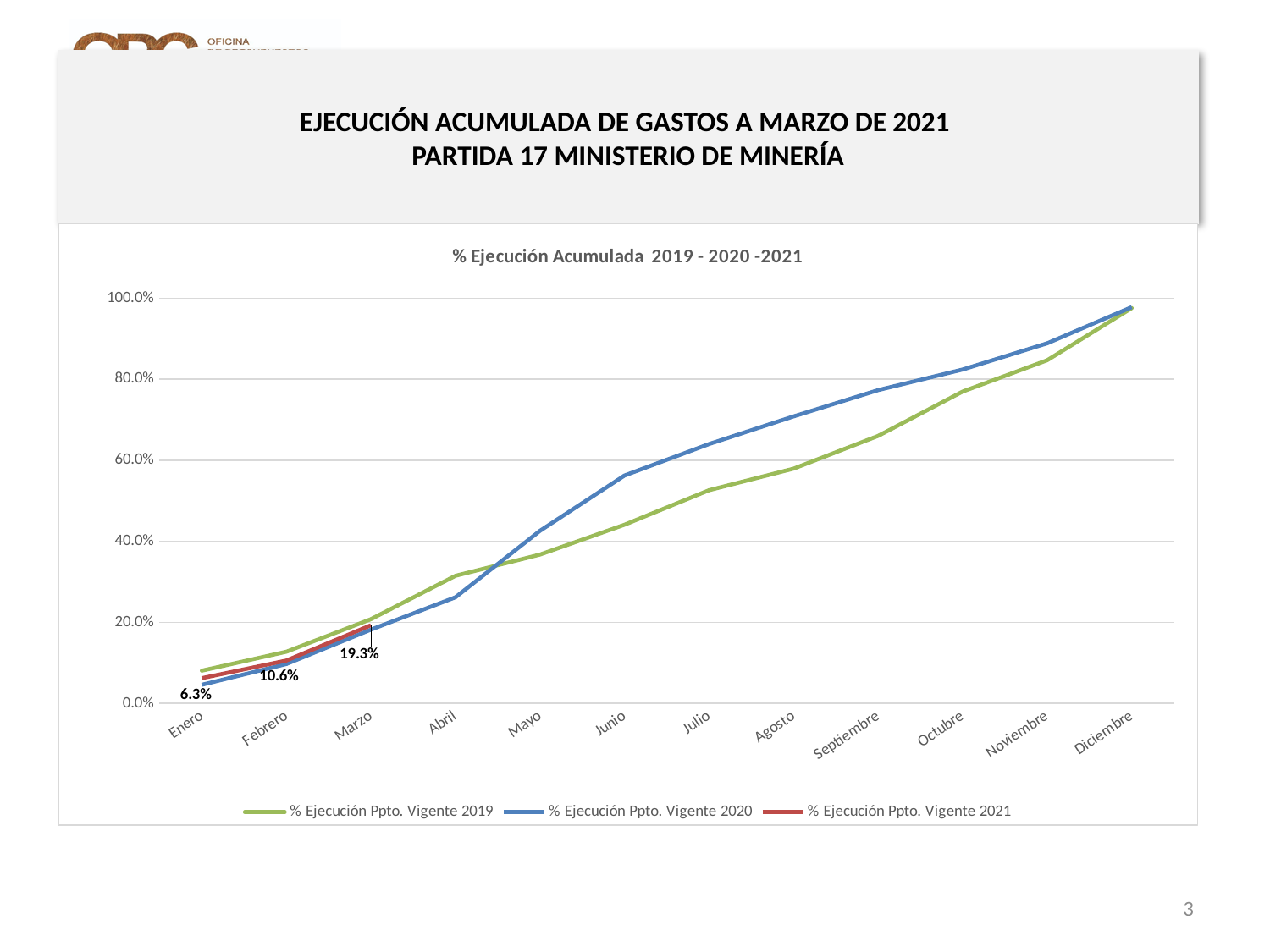
How many months are shown on the x axis of the chart? 12 Is the value for % Ejecución Ppto. Vigente 2019 in Octubre greater or less than 80.0%? less In Junio, which series has the larger value: % Ejecución Ppto. Vigente 2019 or % Ejecución Ppto. Vigente 2020? % Ejecución Ppto. Vigente 2020 What is the title of the chart? % Ejecución Acumulada 2019 - 2020 -2021 What is the value of % Ejecución Ppto. Vigente 2021 in Enero? 6.3% By how many percentage points did % Ejecución Ppto. Vigente 2021 increase from Febrero to Marzo? 8.7 percentage points How many series does the legend list? 3 What is the value of % Ejecución Ppto. Vigente 2021 in Febrero? 10.6% Is the value for % Ejecución Ppto. Vigente 2020 in Junio greater or less than 40.0%? greater Do the values for % Ejecución Ppto. Vigente 2020 rise or fall from Enero to Diciembre? Rise What kind of chart is shown on the slide? Line chart What is the value of % Ejecución Ppto. Vigente 2021 in Marzo? 19.3%